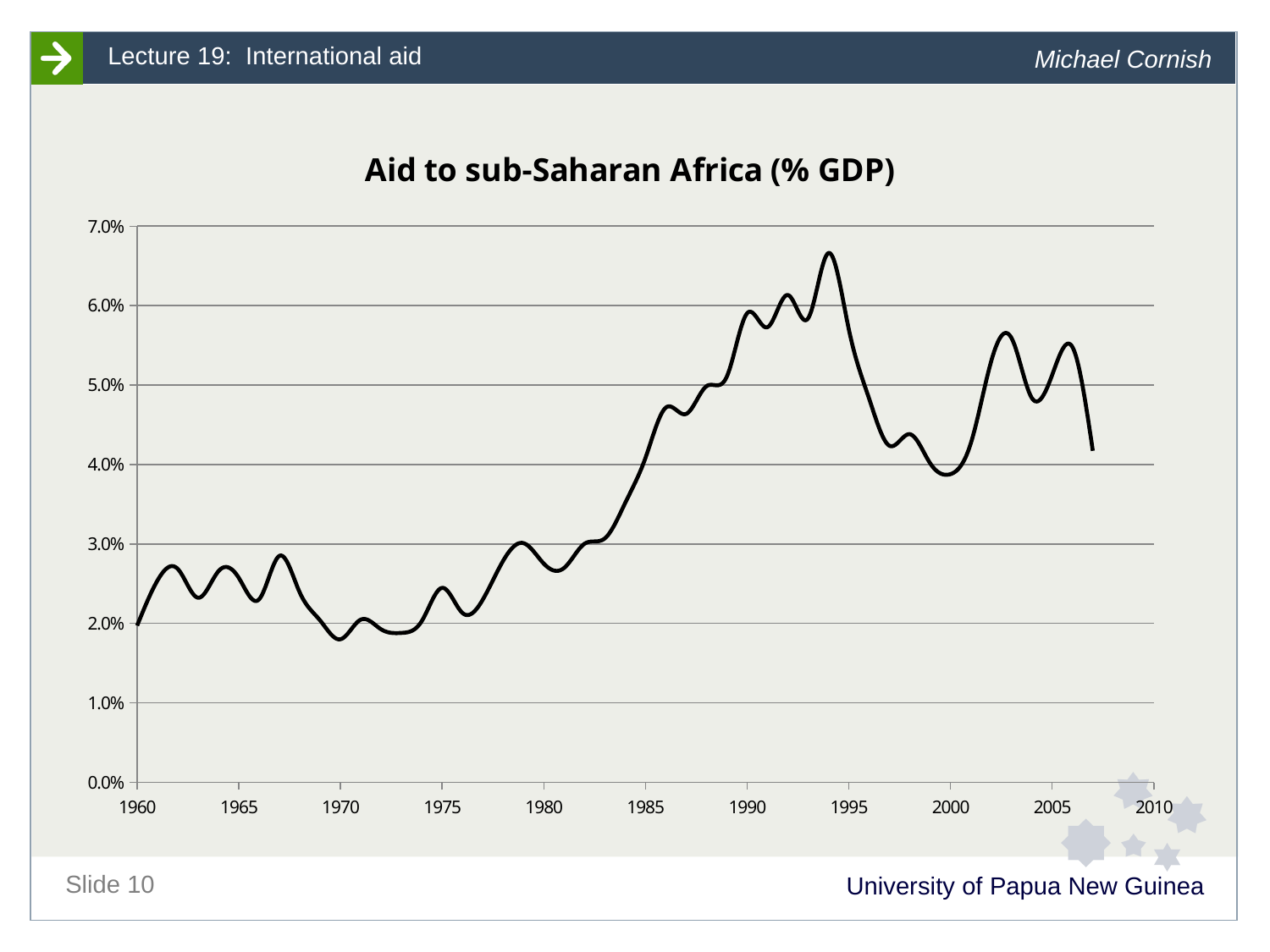
Is the value for 1990 greater or less than 5.0%? greater Does the line rise or fall between 1994 and 2000? fall What is the title of the chart? Aid to sub-Saharan Africa (% GDP) Is the value for 1970 greater or less than 2.0%? less What kind of chart is shown on the slide? line chart Is the highest point on the line greater or less than 6.0%? greater Which year has the larger value, 1970 or 1990? 1990 How many lines are plotted on the chart? 1 Which year has the larger value, 1960 or 1995? 1995 Does the line generally rise or fall between 1975 and 1994? rise